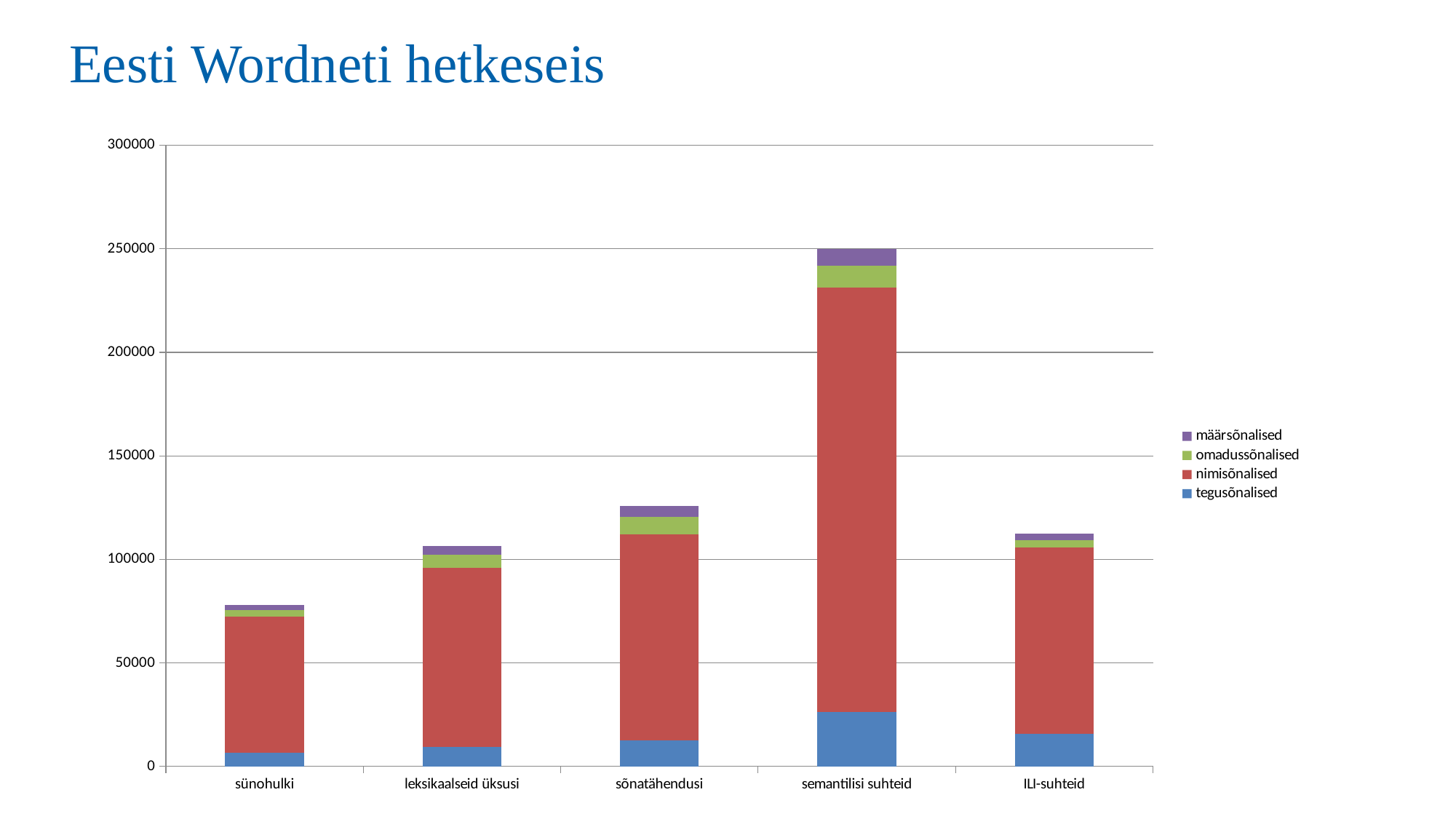
Which series is shown in red in the chart? nimisõnalised Is the total stacked value for sõnatähendusi greater or less than 100000? greater Which has the larger total stacked bar, sõnatähendusi or ILI-suhteid? sõnatähendusi How many series does the chart's legend list? 4 Is the tegusõnalised value for semantilisi suhteid greater or less than 50000? less How many categories are shown on the x axis of the chart? 5 Is the total stacked value for semantilisi suhteid greater or less than 200000? greater What type of chart is shown on the slide? stacked bar chart What is the title of the slide containing the chart? Eesti Wordneti hetkeseis Which category has the lowest total stacked bar? sünohulki Which category has the highest total stacked bar? semantilisi suhteid